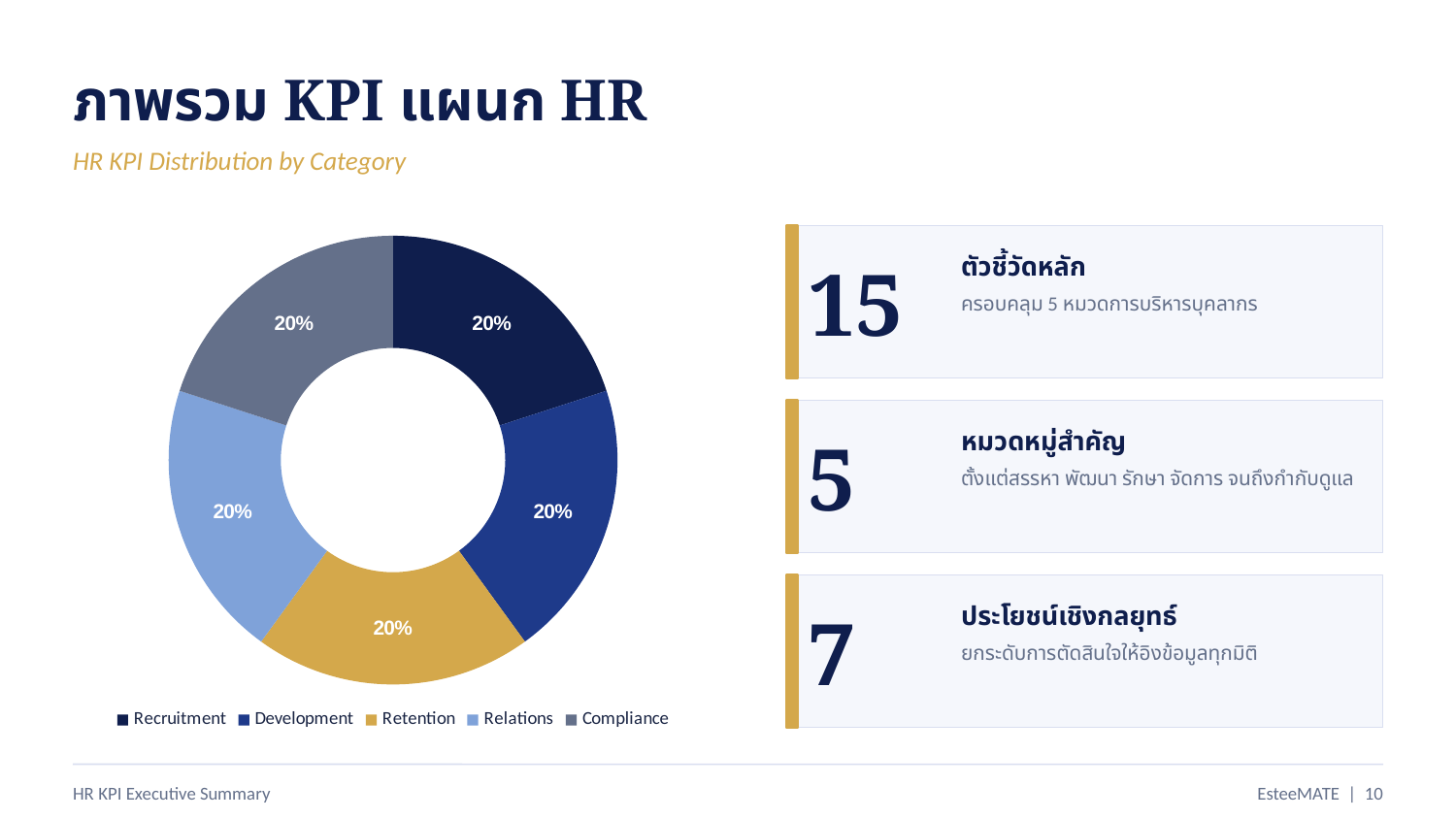
What is the value for the Relations slice? 20% How many categories are shown in the chart? 5 What share of the pie does Recruitment account for? 20% Which legend entry is shown in gold/yellow? Retention What percentage is shown for Compliance? 20% What is the difference between the Recruitment and Compliance shares? 0% What is the combined share of Recruitment and Development? 40% What percentage does the Development slice show? 20% How many entries does the legend list? 5 What is the value shown for the Retention slice? 20% What is the subtitle of the chart shown on the slide? HR KPI Distribution by Category What kind of chart is shown on the slide? Pie chart (donut)